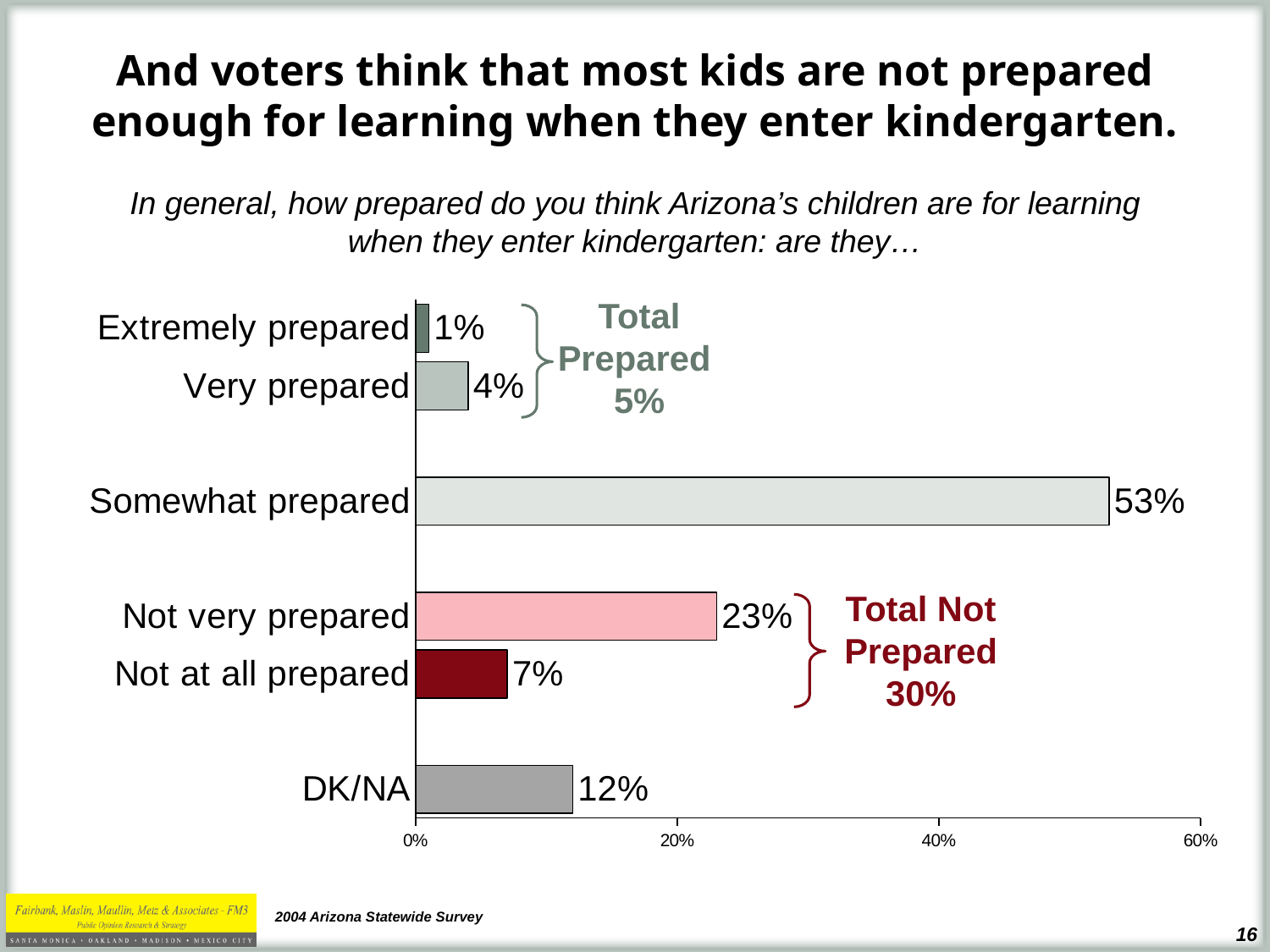
Is the value for Somewhat prepared greater or less than 40%? greater Which category has the lowest value in the chart? Extremely prepared What is the value shown for DK/NA? 12% What is the Total Prepared percentage shown on the chart? 5% Which category has the highest value in the chart? Somewhat prepared What is the Total Not Prepared percentage shown on the chart? 30% What kind of chart is shown on the slide? Bar chart What is the difference between the values for Not very prepared and Not at all prepared? 16% What percentage of respondents said children are not very prepared? 23% Which is larger, the value for Very prepared or the value for Not at all prepared? Not at all prepared How many categories are shown in the chart? 6 What percentage of respondents said Arizona's children are somewhat prepared for kindergarten? 53%